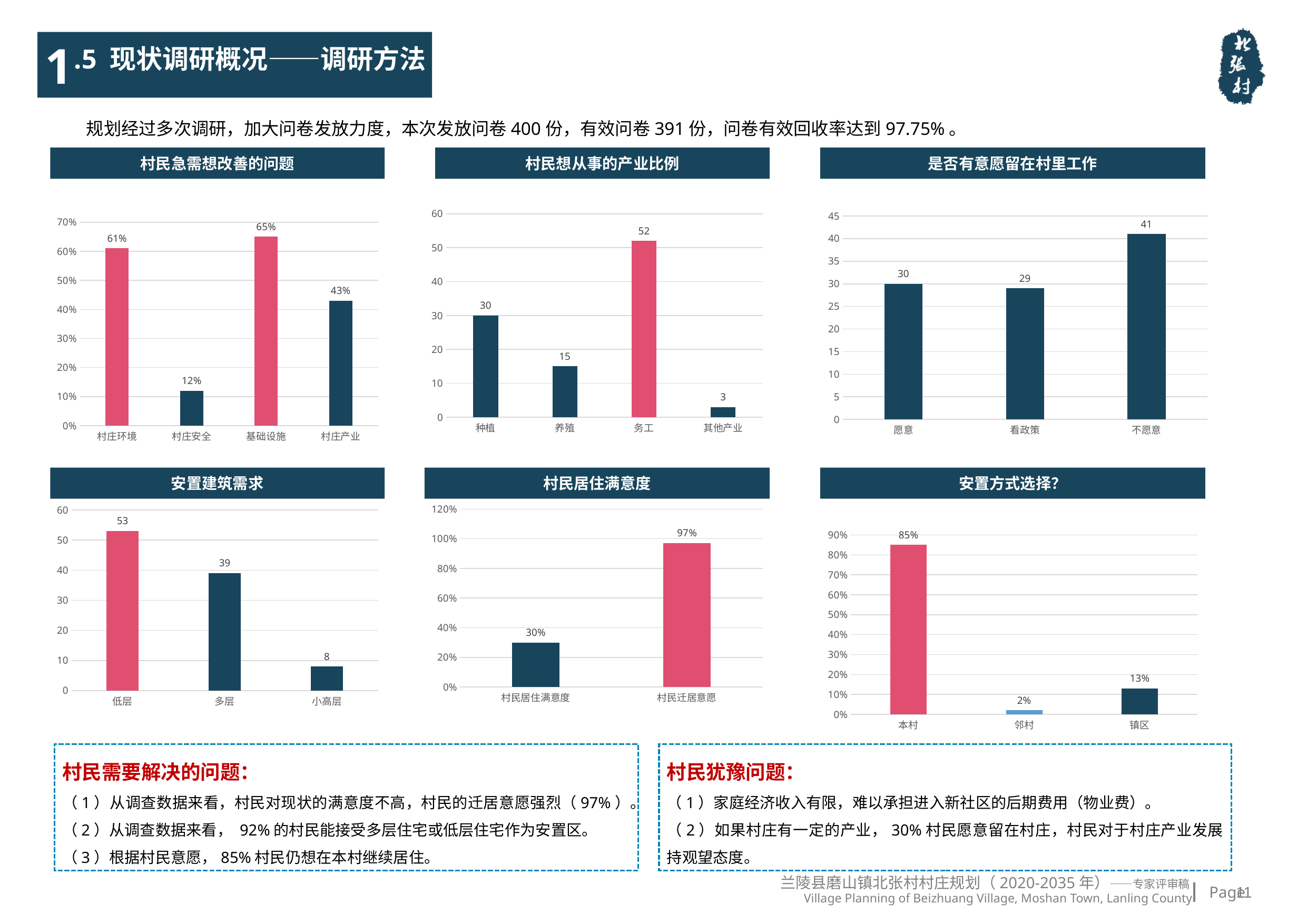
In the chart titled 村民想从事的产业比例, what is the difference between 种植 and 养殖? 15 In the chart titled 村民急需想改善的问题, which category has the lowest value? 村庄安全 In the chart titled 安置建筑需求, what is the value for 多层? 39 In the chart titled 是否有意愿留在村里工作, how many categories are shown? 3 In the chart titled 村民想从事的产业比例, what is the value for 务工? 52 In the chart titled 安置建筑需求, what is the total of 低层 and 多层? 92 In the chart titled 村民居住满意度, which is larger, 村民居住满意度 or 村民迁居意愿? 村民迁居意愿 In the chart titled 村民急需想改善的问题, what is the value for 基础设施? 65% In the chart titled 是否有意愿留在村里工作, which category has the highest value? 不愿意 What type of chart is the one titled 村民想从事的产业比例? Bar chart In the chart titled 安置方式选择?, what is the value for 邻村? 2% In the chart titled 安置方式选择?, what is the difference between 本村 and 镇区? 72%